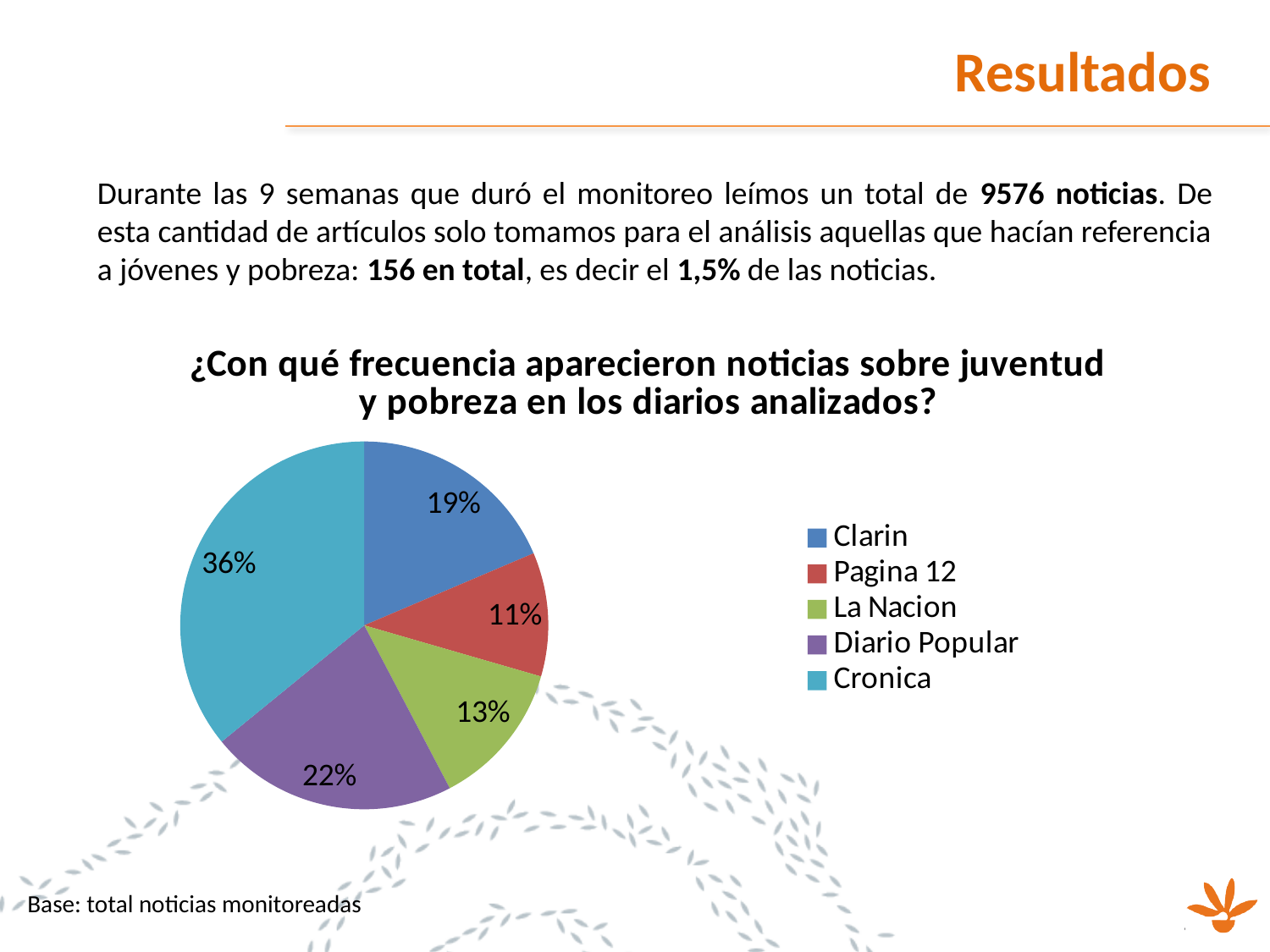
What is the difference in percentage points between Cronica and Clarin? 17 What share of the pie does La Nacion have? 13% Which newspaper has the smallest slice of the pie? Pagina 12 What share of the pie does Diario Popular have? 22% What kind of chart is shown on the slide? pie chart What colour is the slice for Diario Popular? purple How many newspapers are listed in the legend? 5 Which newspaper has the largest slice of the pie? Cronica What share of the pie does Clarin have? 19% Which has a larger share, Diario Popular or La Nacion? Diario Popular